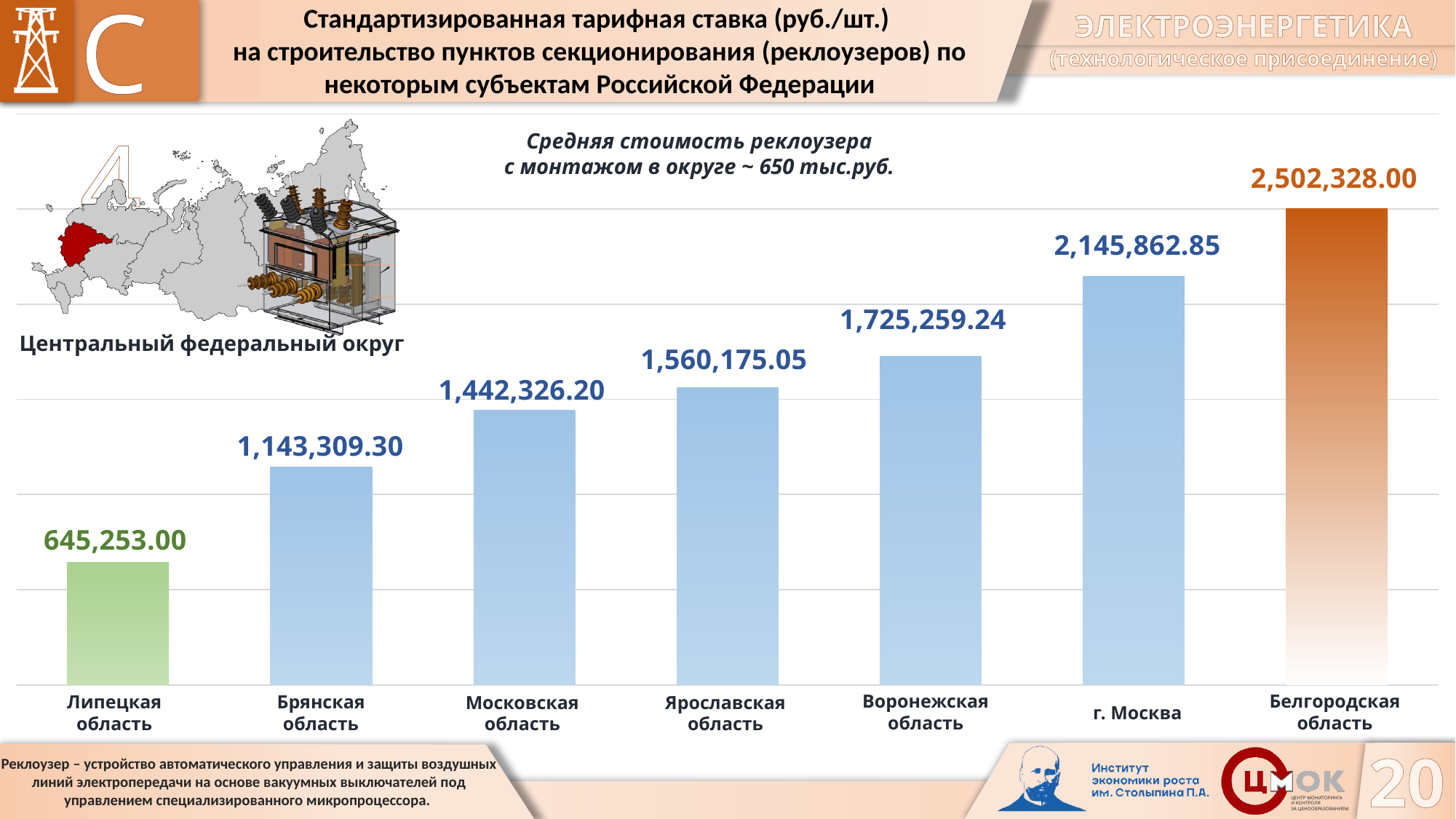
What kind of chart is shown on the slide? Bar chart What is the difference between the values for Белгородская область and Липецкая область? 1,857,075.00 Which is larger, the value for Ярославская область or Московская область? Ярославская область What is the difference between the values for г. Москва and Воронежская область? 420,603.61 What is the standardized tariff rate for Липецкая область? 645,253.00 How many regions are shown in the chart? 7 Do the values rise or fall from left to right across the chart? Rise What is the value shown for г. Москва? 2,145,862.85 Which federal district does the chart cover, according to the label next to the map? Центральный федеральный округ Which region has the highest standardized tariff rate? Белгородская область What is the value shown for Воронежская область? 1,725,259.24 Which region has the lowest standardized tariff rate? Липецкая область